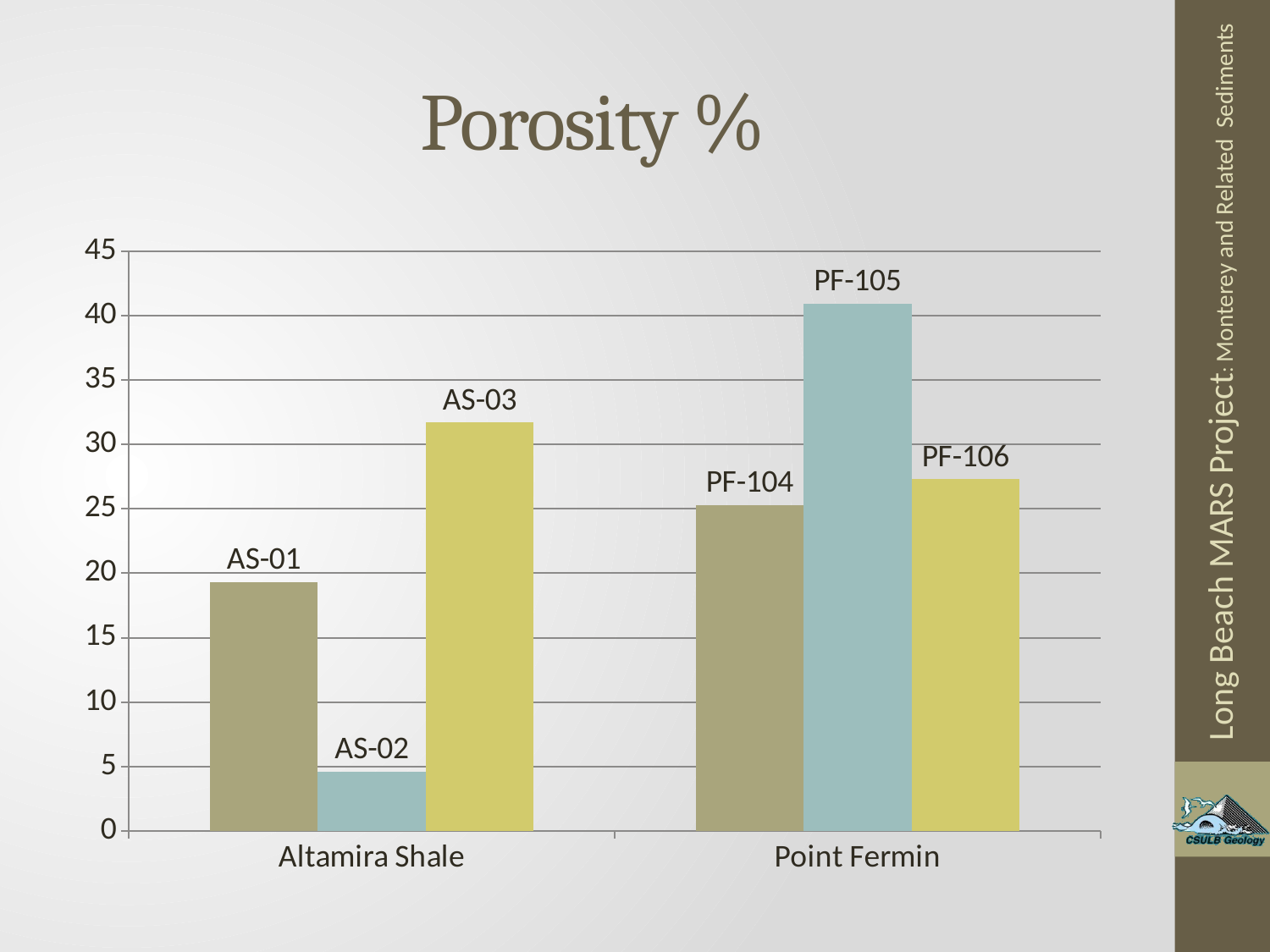
Is the porosity value for AS-01 greater or less than 20? less What is the title of the chart? Porosity % How many bars are plotted in total on the chart? 6 What kind of chart is shown on the slide? bar chart How many categories are shown on the x axis? 2 Which sample has the highest porosity? PF-105 Which sample has the lowest porosity? AS-02 Is the porosity value for AS-02 greater or less than 5? less Is the porosity value for PF-105 greater or less than 40? greater Which has the higher porosity, AS-03 or PF-106? AS-03 Which samples belong to the Point Fermin category? PF-104, PF-105, PF-106 Which has the higher porosity, AS-01 or PF-104? PF-104